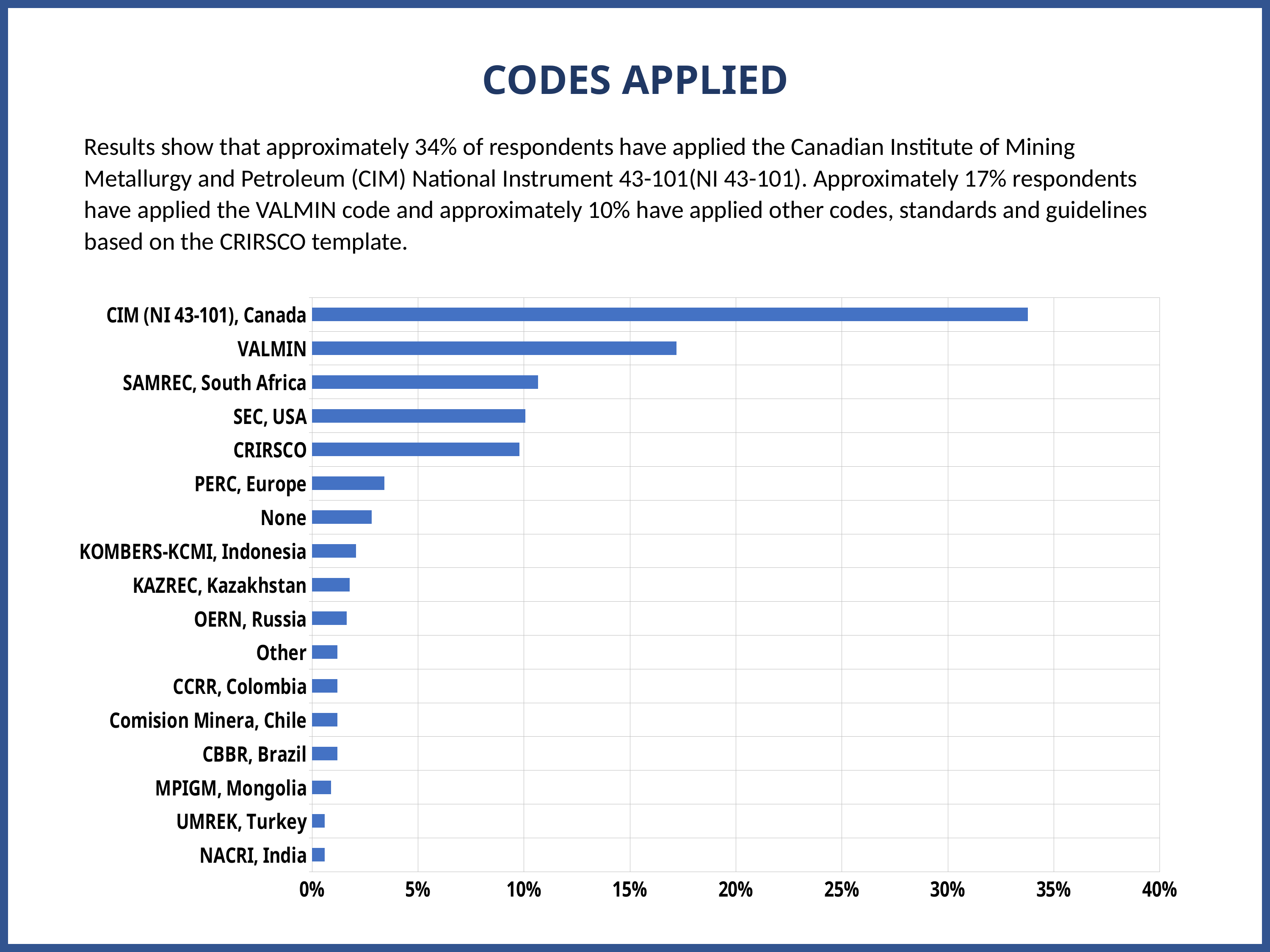
Is the value for PERC, Europe greater or less than 5%? less What is the maximum value shown on the horizontal axis? 40% Which is larger, the value for CIM (NI 43-101), Canada or the value for VALMIN? CIM (NI 43-101), Canada Which is larger, the value for SAMREC, South Africa or the value for PERC, Europe? SAMREC, South Africa How many categories (codes) are plotted in the chart? 17 Is the value for CIM (NI 43-101), Canada greater or less than 30%? greater Is the value for SAMREC, South Africa greater or less than 15%? less Which category has the highest value in the chart? CIM (NI 43-101), Canada Do the bar values increase or decrease going from the top category to the bottom category? decrease What kind of chart is shown on the slide? bar chart